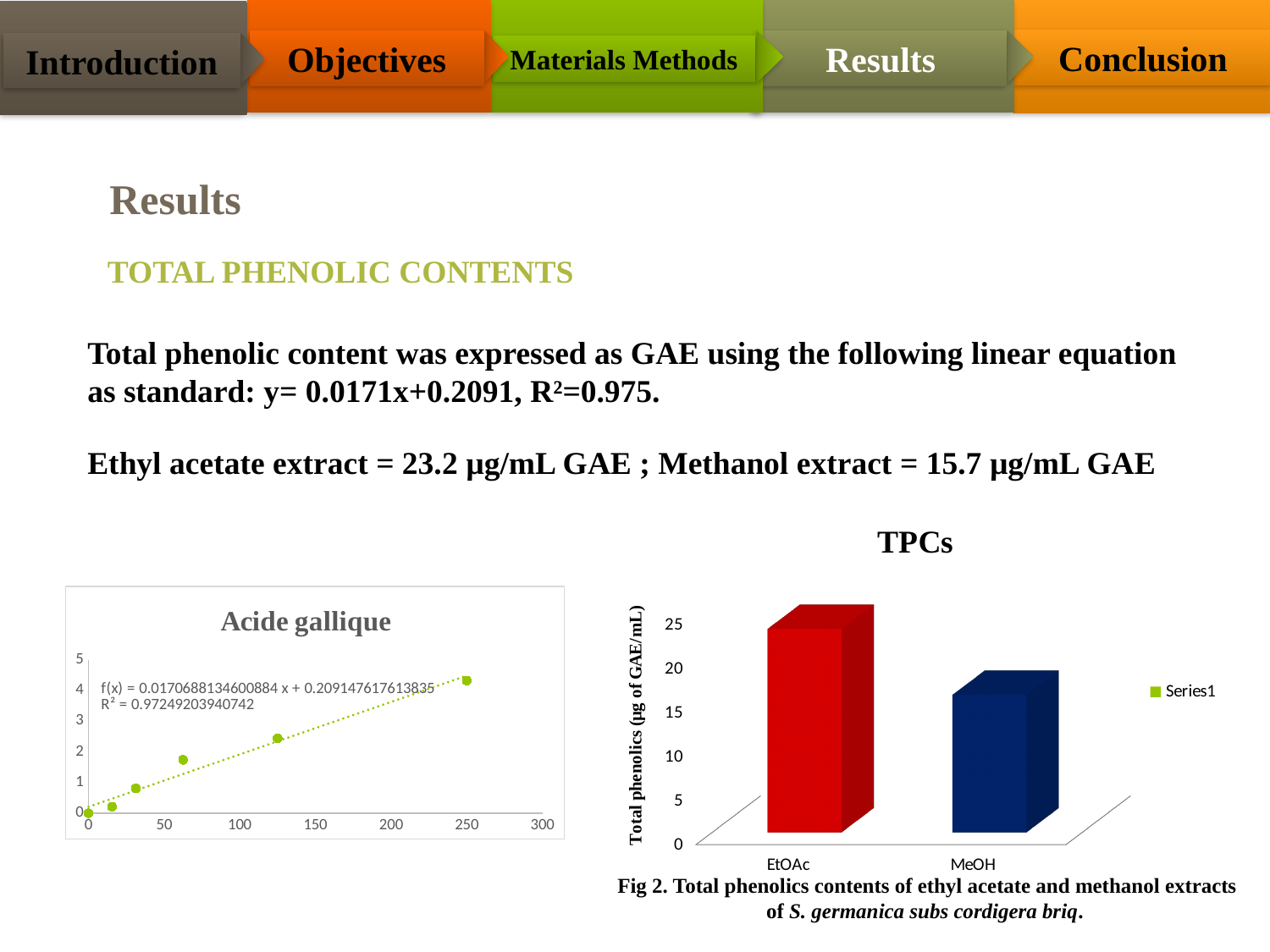
In the TPCs chart, is the value for MeOH greater or less than 20? less What is the y-axis title of the TPCs chart? Total phenolics (µg of GAE/mL) In the TPCs chart, is the value for EtOAc greater or less than 20? greater What is the R² value shown on the Acide gallique chart? 0.97249203940742 In the TPCs chart, how many categories are shown on the x axis? 2 What kind of chart is the TPCs chart? bar chart In the TPCs chart, which extract has the lowest total phenolics value? MeOH What kind of chart is the Acide gallique chart? scatter chart In the TPCs chart, which extract has the highest total phenolics value? EtOAc How many series does the legend of the TPCs chart list? 1 In the Acide gallique chart, do the plotted values rise or fall as x increases? rise In the TPCs chart, which bar is taller, EtOAc or MeOH? EtOAc